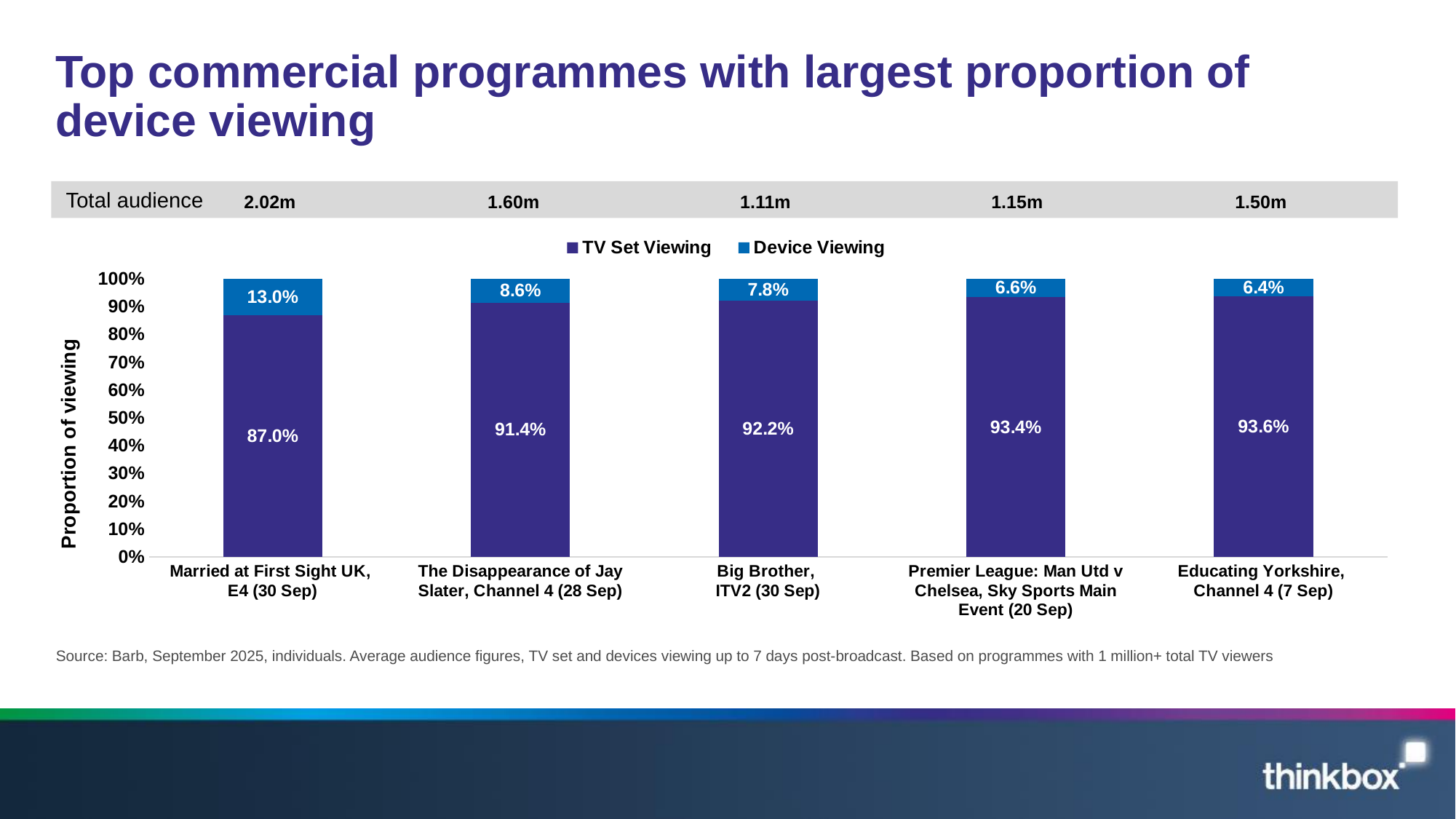
What is the total audience shown for The Disappearance of Jay Slater, Channel 4 (28 Sep)? 1.60m Is the TV Set Viewing share for Married at First Sight UK, E4 (30 Sep) greater or less than 90%? less What is the TV Set Viewing share for Big Brother, ITV2 (30 Sep)? 92.2% What is the Device Viewing share for Educating Yorkshire, Channel 4 (7 Sep)? 6.4% What is the Device Viewing share for Married at First Sight UK, E4 (30 Sep)? 13.0% Which has a larger TV Set Viewing share: Big Brother, ITV2 (30 Sep) or Premier League: Man Utd v Chelsea, Sky Sports Main Event (20 Sep)? Premier League: Man Utd v Chelsea, Sky Sports Main Event (20 Sep) How many programmes are shown on the chart? 5 Which programme has the lowest Device Viewing share? Educating Yorkshire, Channel 4 (7 Sep) What is the difference in Device Viewing share between Married at First Sight UK and The Disappearance of Jay Slater? 4.4% How many series does the legend list? 2 Which programme has the highest Device Viewing share? Married at First Sight UK, E4 (30 Sep) What kind of chart is shown on the slide? Stacked bar chart